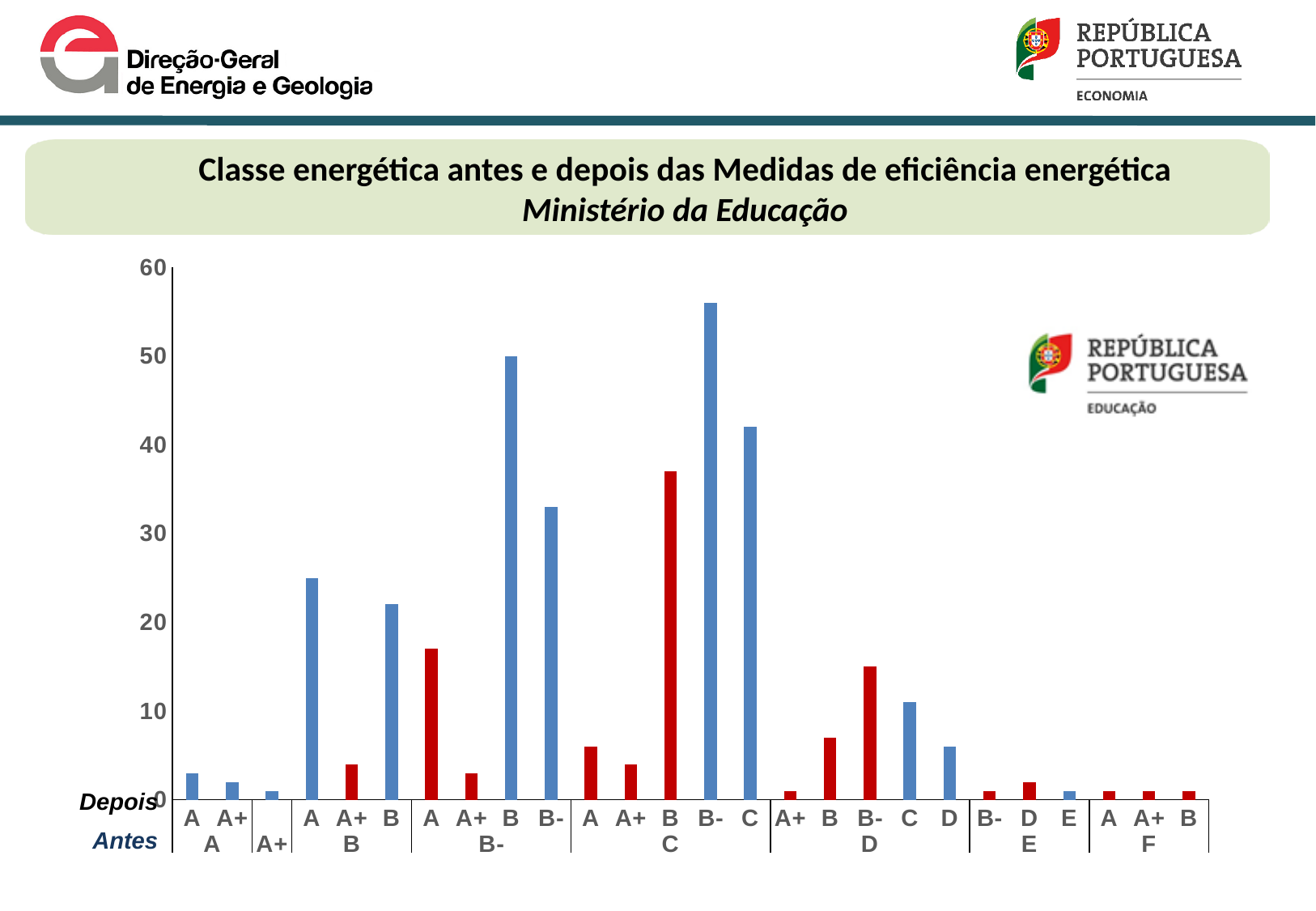
Which is larger: the bar for Antes B-, Depois B or the bar for Antes C, Depois C? Antes B-, Depois B Is the value for Antes B-, Depois B greater or less than 40? greater Is the value for Antes B-, Depois B- greater or less than 30? greater How many 'Antes' groups are shown along the x axis? 8 Is the value for Antes C, Depois B greater or less than 40? less What is the highest value shown on the y axis? 60 Which bar is the tallest in the chart? Antes C, Depois B- What two colours are used for the bars in the chart? blue and red Which is larger: the bar for Antes B-, Depois B or the bar for Antes C, Depois B-? Antes C, Depois B- What kind of chart is shown on the slide? bar chart